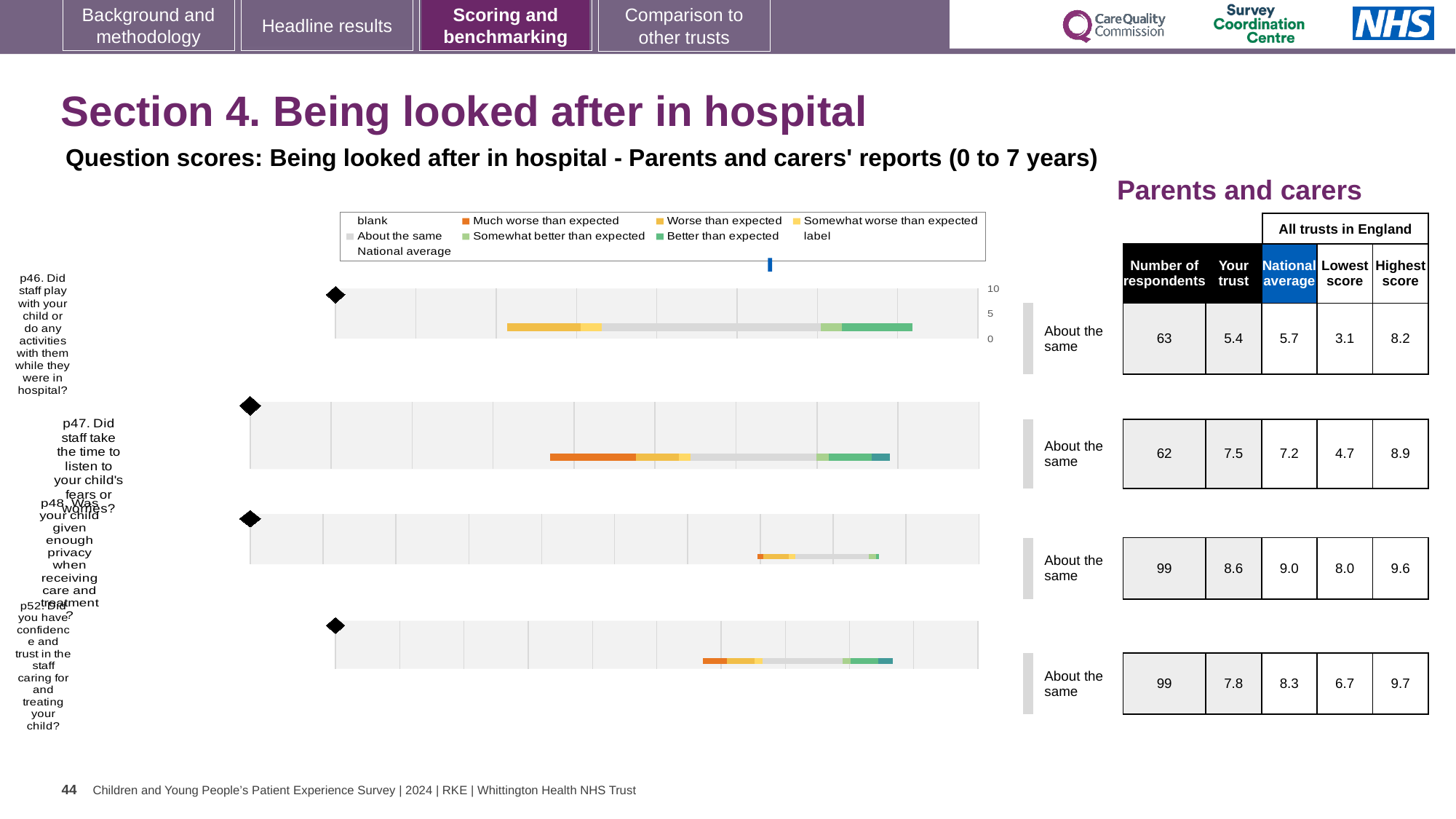
Which question has the lowest 'Your trust' score on this slide? p46 Which question has the highest 'Your trust' score on this slide? p48 For question p46, what is the difference between the national average and the 'Your trust' score? 0.3 What is the national average score for question p47 (Did staff take the time to listen to your child's fears or worries?)? 7.2 For question p47, which is larger: the 'Your trust' score or the national average? Your trust How many respondents answered question p48 (Was your child given enough privacy when receiving care and treatment?)? 99 What kind of chart is used to show the question scores on this slide? Bar chart For question p52, what is the difference between the highest score and the lowest score across all trusts in England? 3.0 What benchmark category is shown for question p46? About the same How many questions are charted on this slide? 4 What is the 'Your trust' score for question p46 (Did staff play with your child or do any activities with them while they were in hospital?)? 5.4 What is the highest score across all trusts in England for question p52 (Did you have confidence and trust in the staff caring for and treating your child?)? 9.7